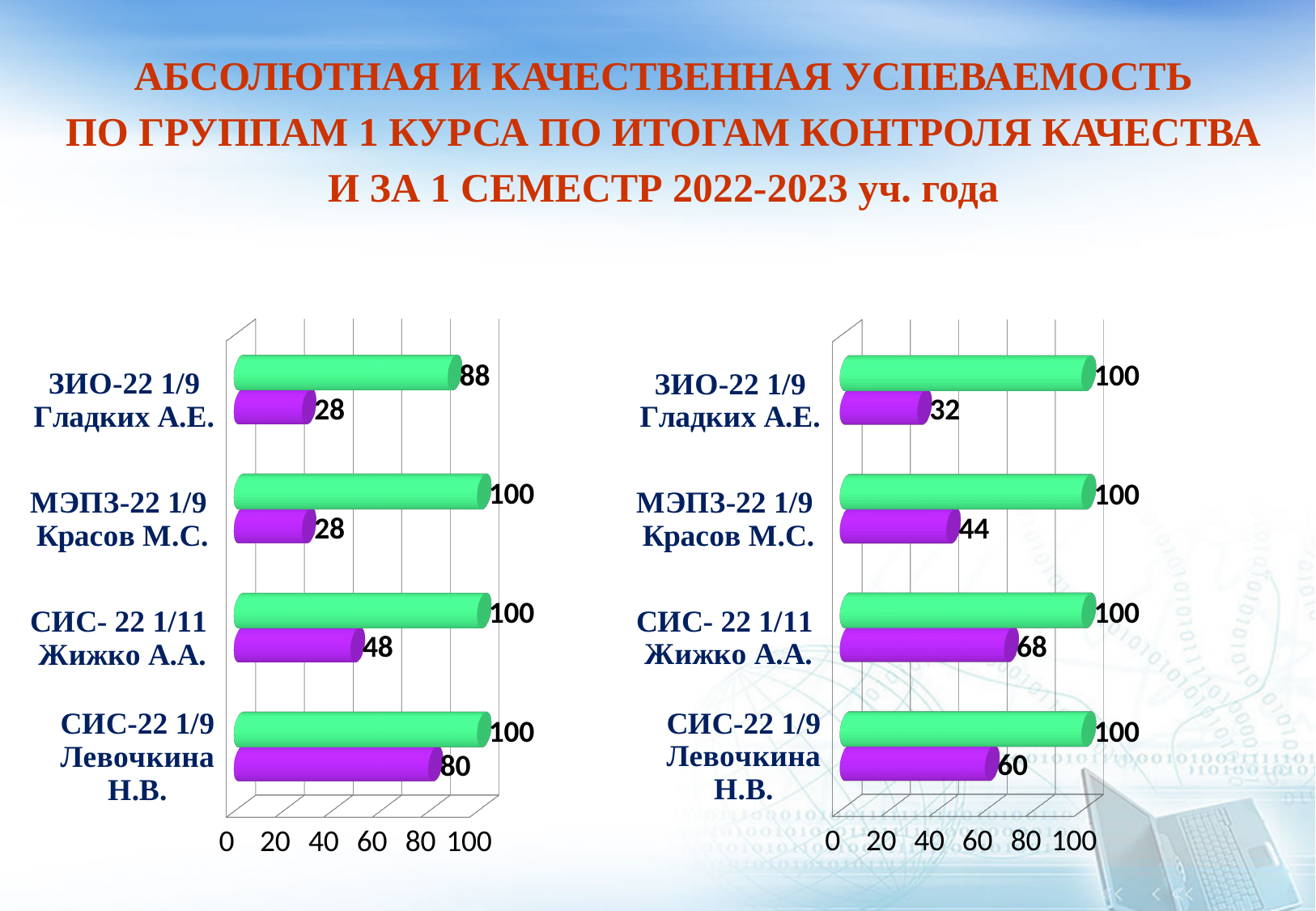
In the left chart, what is the difference between the green and purple bar values for СИС- 22 1/11 Жижко А.А.? 52 In the left chart, what is the value of the purple bar for СИС-22 1/9 Левочкина Н.В.? 80 In the left chart, what is the value of the green bar for ЗИО-22 1/9 Гладких А.Е.? 88 In the right chart, what is the difference between the purple bar values for СИС- 22 1/11 Жижко А.А. and СИС-22 1/9 Левочкина Н.В.? 8 What type of chart is the right chart? Bar chart In the left chart, which is larger: the purple bar for СИС- 22 1/11 Жижко А.А. or the purple bar for МЭПЗ-22 1/9 Красов М.С.? СИС- 22 1/11 Жижко А.А. How many groups (categories) are shown in the left chart? 4 In the left chart, which group has the highest purple bar value? СИС-22 1/9 Левочкина Н.В. In the right chart, what is the value of the purple bar for МЭПЗ-22 1/9 Красов М.С.? 44 In the right chart, which group has the lowest purple bar value? ЗИО-22 1/9 Гладких А.Е. In the right chart, what is the value of the purple bar for СИС- 22 1/11 Жижко А.А.? 68 In the left chart, which group has a green bar value below 100? ЗИО-22 1/9 Гладких А.Е.